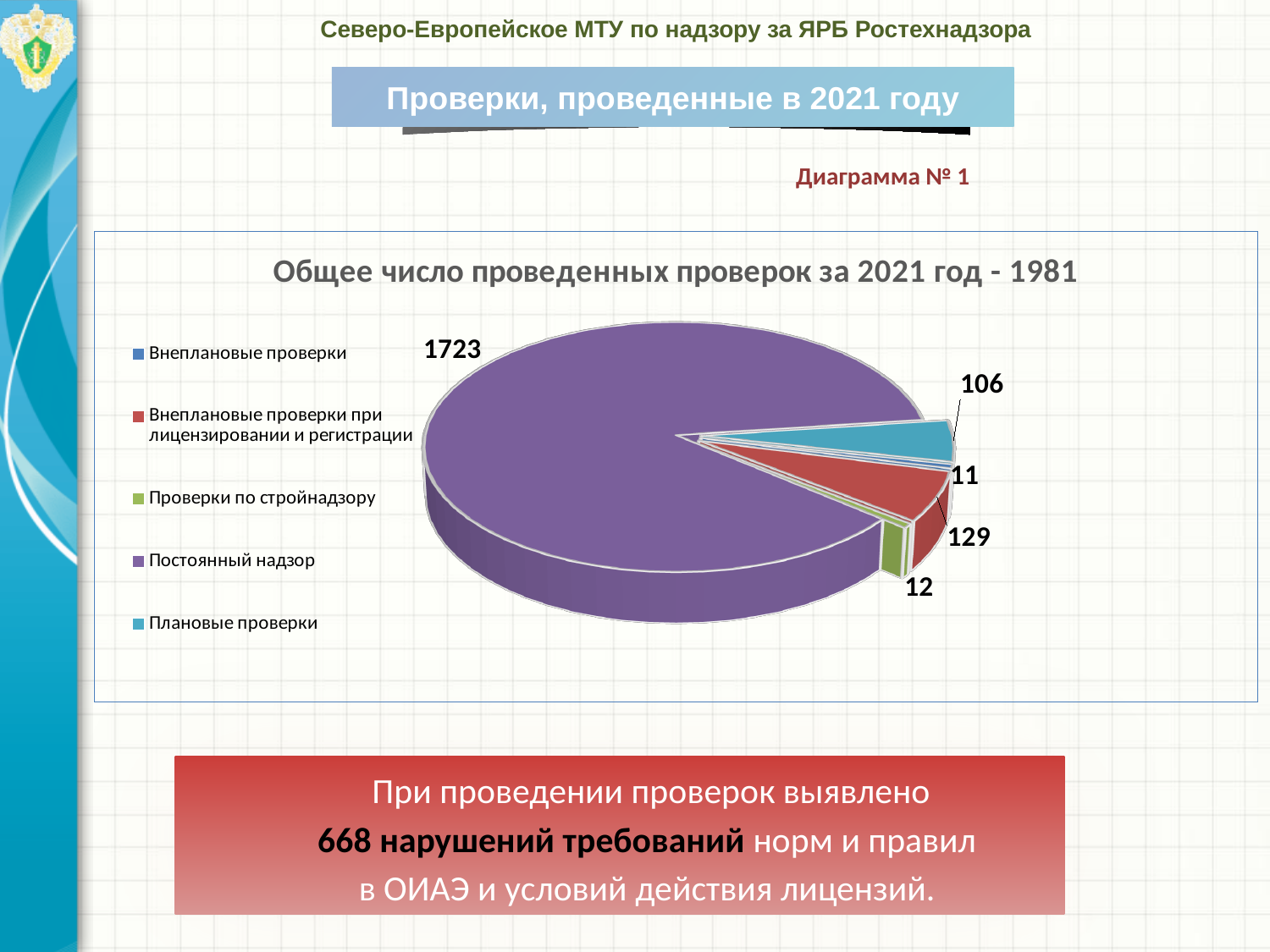
What is the total number of inspections shown in the chart title? 1981 What is the value for Внеплановые проверки при лицензировании и регистрации? 129 What is the value for Постоянный надзор? 1723 What type of chart is shown on the slide? pie chart What is the value for Проверки по стройнадзору? 12 What is the value for Плановые проверки? 106 What is the title of the chart? Общее число проведенных проверок за 2021 год - 1981 Which is larger: Плановые проверки or Внеплановые проверки при лицензировании и регистрации? Внеплановые проверки при лицензировании и регистрации Which category has the largest slice of the pie? Постоянный надзор What is the difference between the values for Внеплановые проверки при лицензировании и регистрации and Плановые проверки? 23 How many categories does the legend of the pie chart list? 5 What is the value for Внеплановые проверки? 11